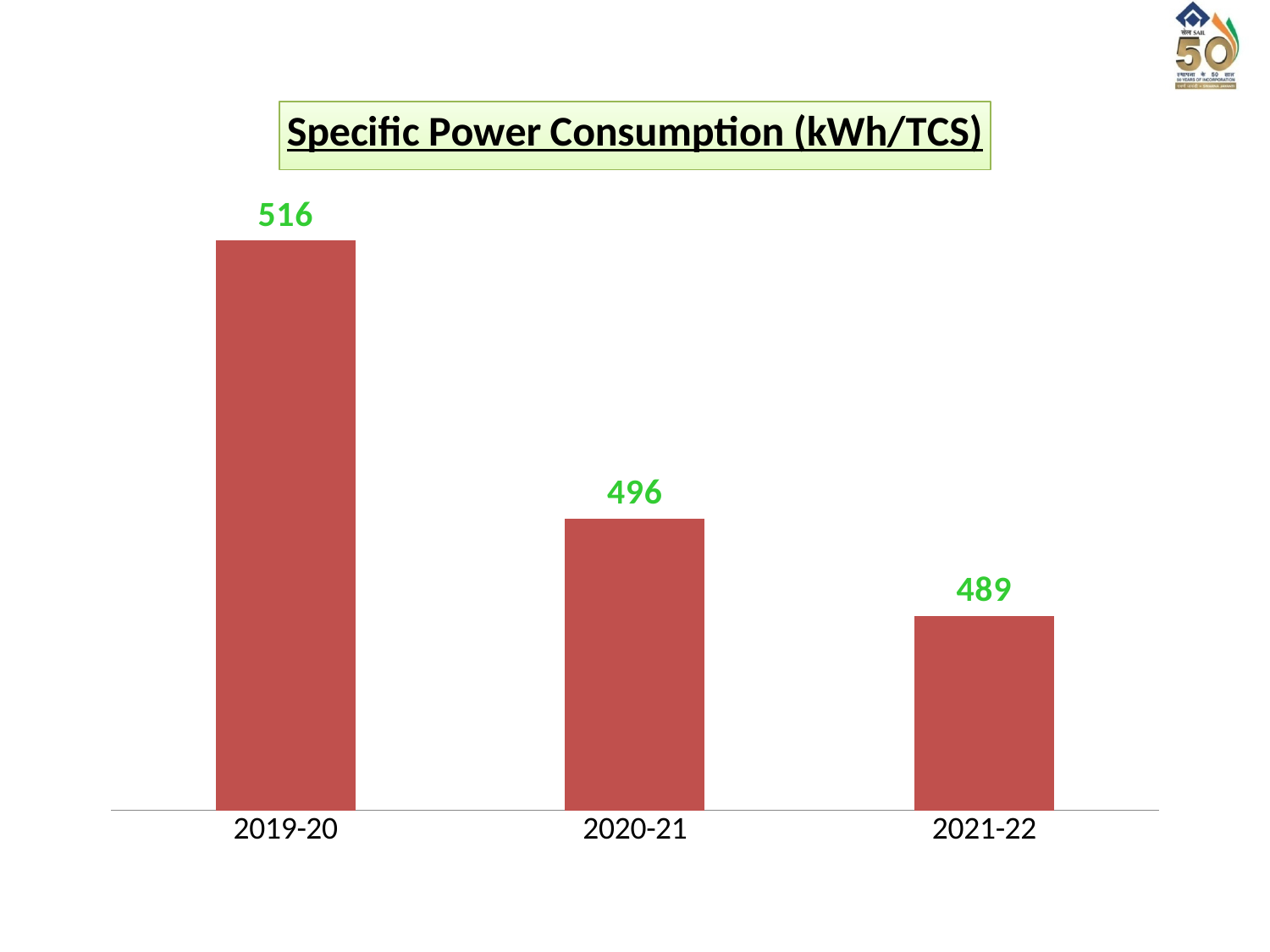
Which year has the lowest specific power consumption? 2021-22 What is the difference in specific power consumption between 2019-20 and 2021-22? 27 What is the difference in specific power consumption between 2020-21 and 2021-22? 7 How many years are shown in the chart? 3 What is the specific power consumption for 2021-22? 489 What is the specific power consumption for 2019-20? 516 What kind of chart is shown on the slide? Bar chart What is the specific power consumption for 2020-21? 496 Which year has a larger specific power consumption, 2019-20 or 2020-21? 2019-20 Which year has the highest specific power consumption? 2019-20 Do the values rise or fall from 2019-20 to 2021-22? Fall What is the title of the chart? Specific Power Consumption (kWh/TCS)